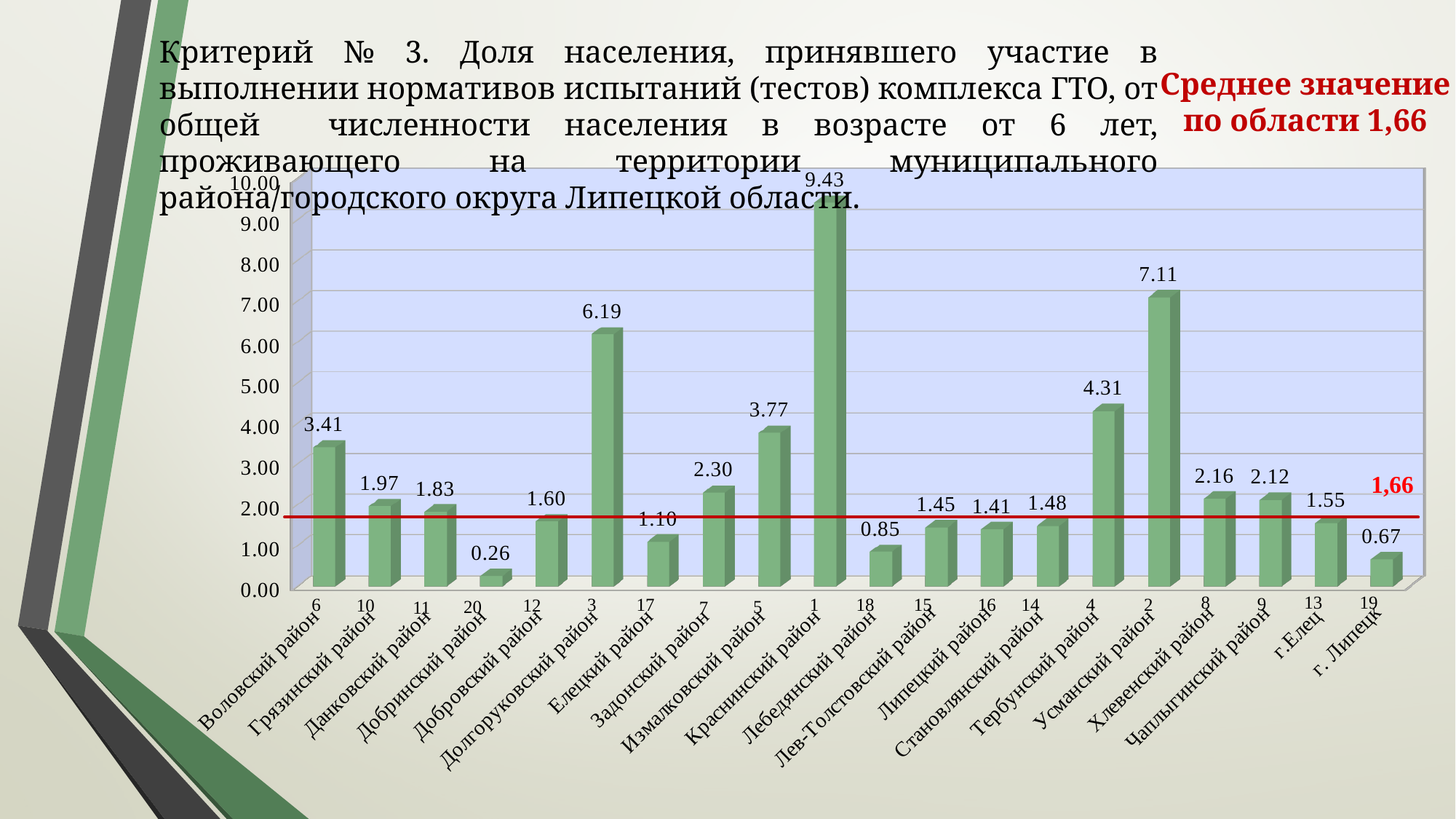
What value is shown for Усманский район? 7.11 What value is shown for г. Липецк? 0.67 What is the difference between the values for Краснинский район and Усманский район? 2.32 What value is shown for Добринский район? 0.26 Which category has the highest value? Краснинский район What value does the red horizontal line on the chart mark? 1,66 How many categories are shown on the x axis? 20 What kind of chart is shown on the slide? bar chart Which category has the lowest value? Добринский район What value is shown for Краснинский район? 9.43 Which is larger, the value for Долгоруковский район or the value for Тербунский район? Долгоруковский район Is the value for Измалковский район greater or less than 3.00? greater